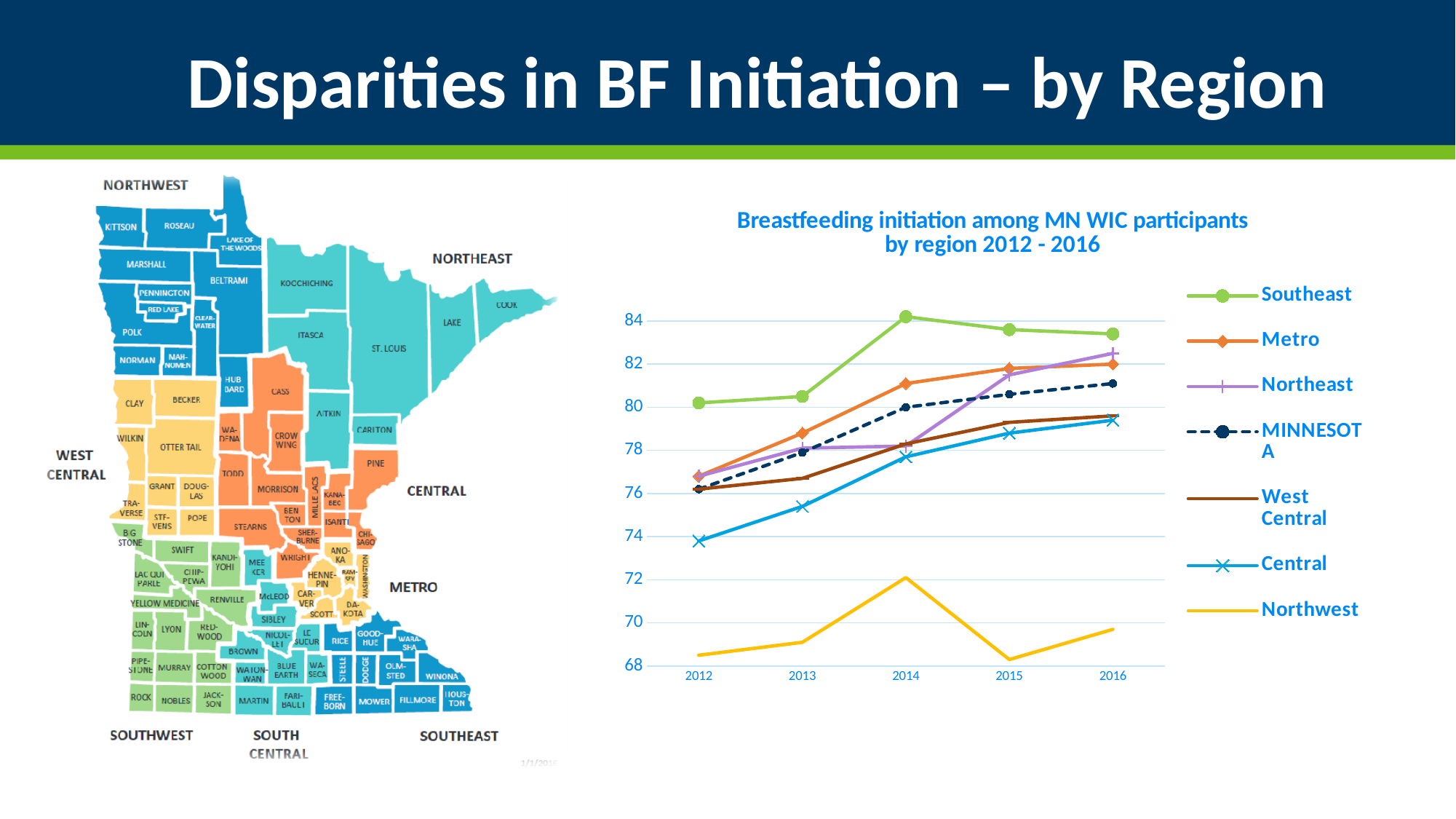
Which region has the lowest breastfeeding initiation value in 2016? Northwest Is the value for Northwest in 2015 greater or less than 70? less Which region has the highest value in 2014? Southeast Does the Northwest line rise or fall from 2014 to 2015? Fall Is the value for Central in 2012 greater or less than 76? less What kind of chart is shown on the slide? Line chart How many series does the chart legend list? 7 Is the value for Northeast in 2016 greater or less than 82? greater Which region has the highest breastfeeding initiation value in 2016? Southeast What is the title of the chart? Breastfeeding initiation among MN WIC participants by region 2012 - 2016 How many years are plotted along the x axis of the chart? 5 In 2012, which is larger: the value for Metro or the value for Central? Metro